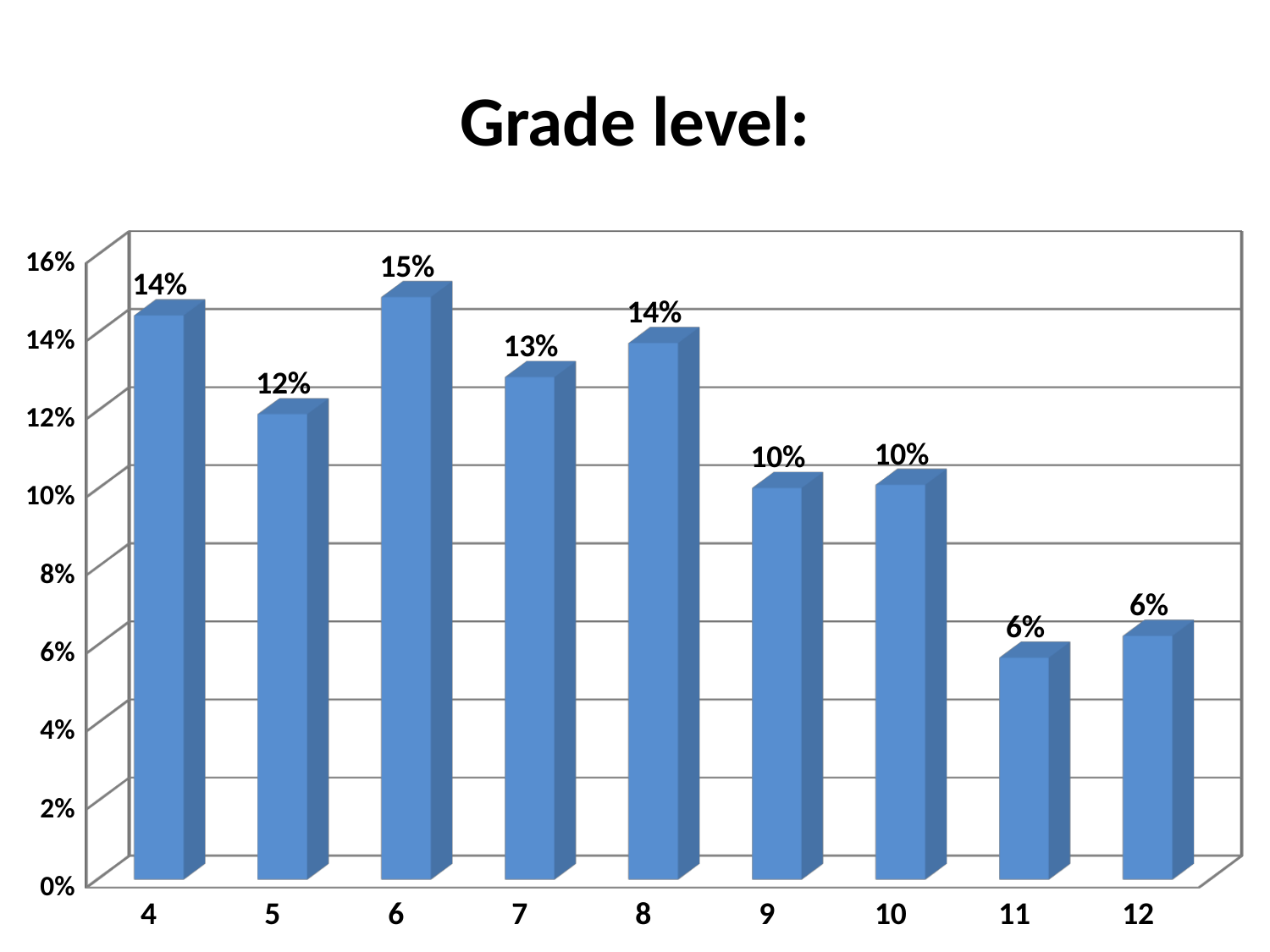
What is the value for grade 12? 6% What kind of chart is shown on the slide? bar chart Which is larger, the value for grade 7 or the value for grade 10? grade 7 What is the value for grade 9? 10% Is the value for grade 8 greater or less than 12%? greater What is the value for grade 6? 15% What is the difference between the values for grade 6 and grade 5? 3% How many grade levels are shown on the x axis? 9 Which grade level has the highest value? 6 What is the difference between the values for grade 4 and grade 11? 8% Do the values generally rise or fall from grade 8 to grade 12? fall What is the title of the chart? Grade level: